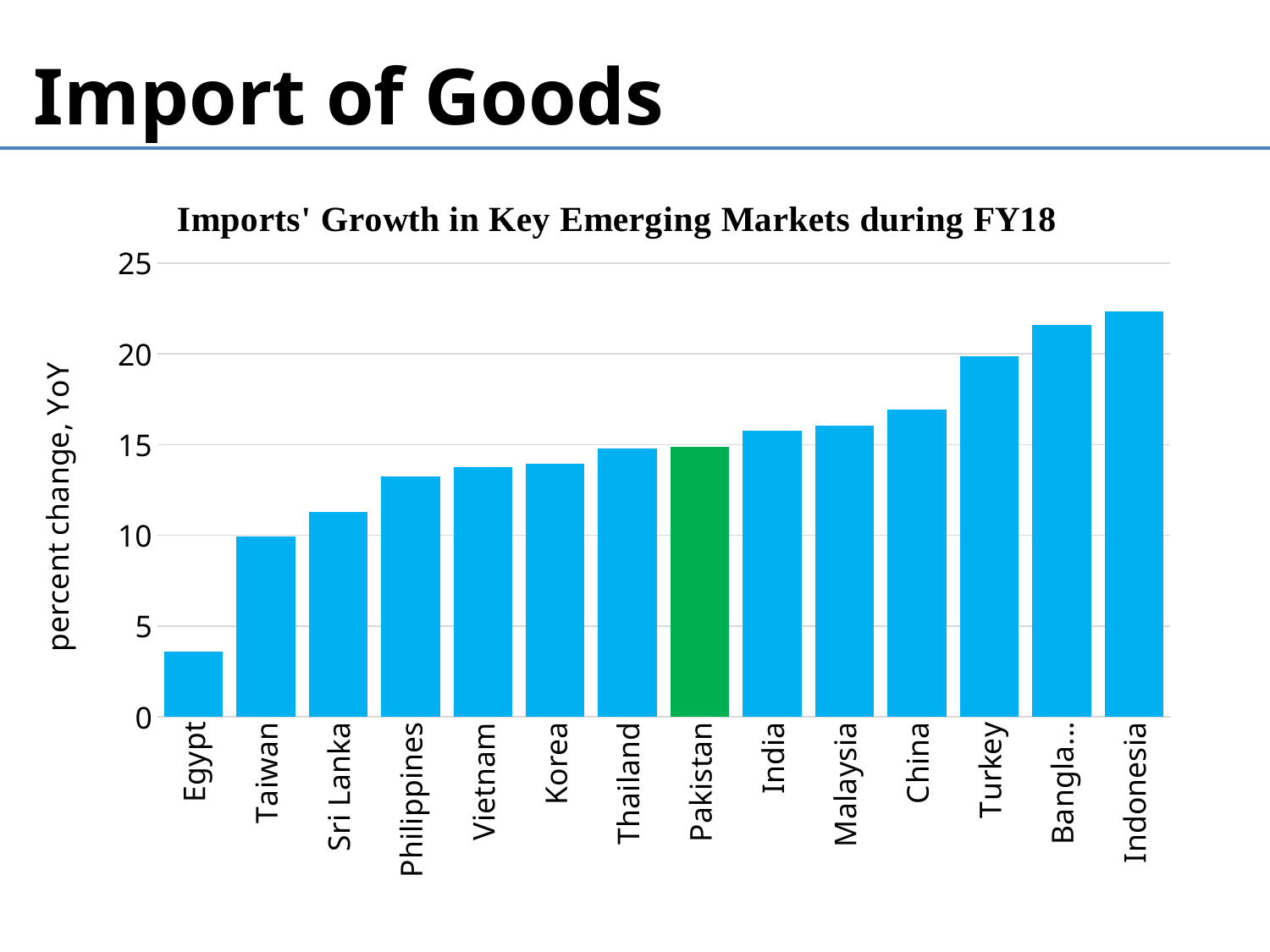
Which country's bar is coloured green instead of blue? Pakistan Is the value for China greater or less than 15? greater Which country has the highest import growth in the chart? Indonesia How many countries are shown on the x axis of the chart? 14 Is the value for Egypt greater or less than 5? less What is the title of the chart? Imports' Growth in Key Emerging Markets during FY18 What kind of chart is shown on the slide? bar chart Do the values generally rise or fall moving from left to right along the x axis? rise Is the value for Indonesia greater or less than 20? greater Which country has the lowest import growth in the chart? Egypt Which has the larger value, Turkey or China? Turkey